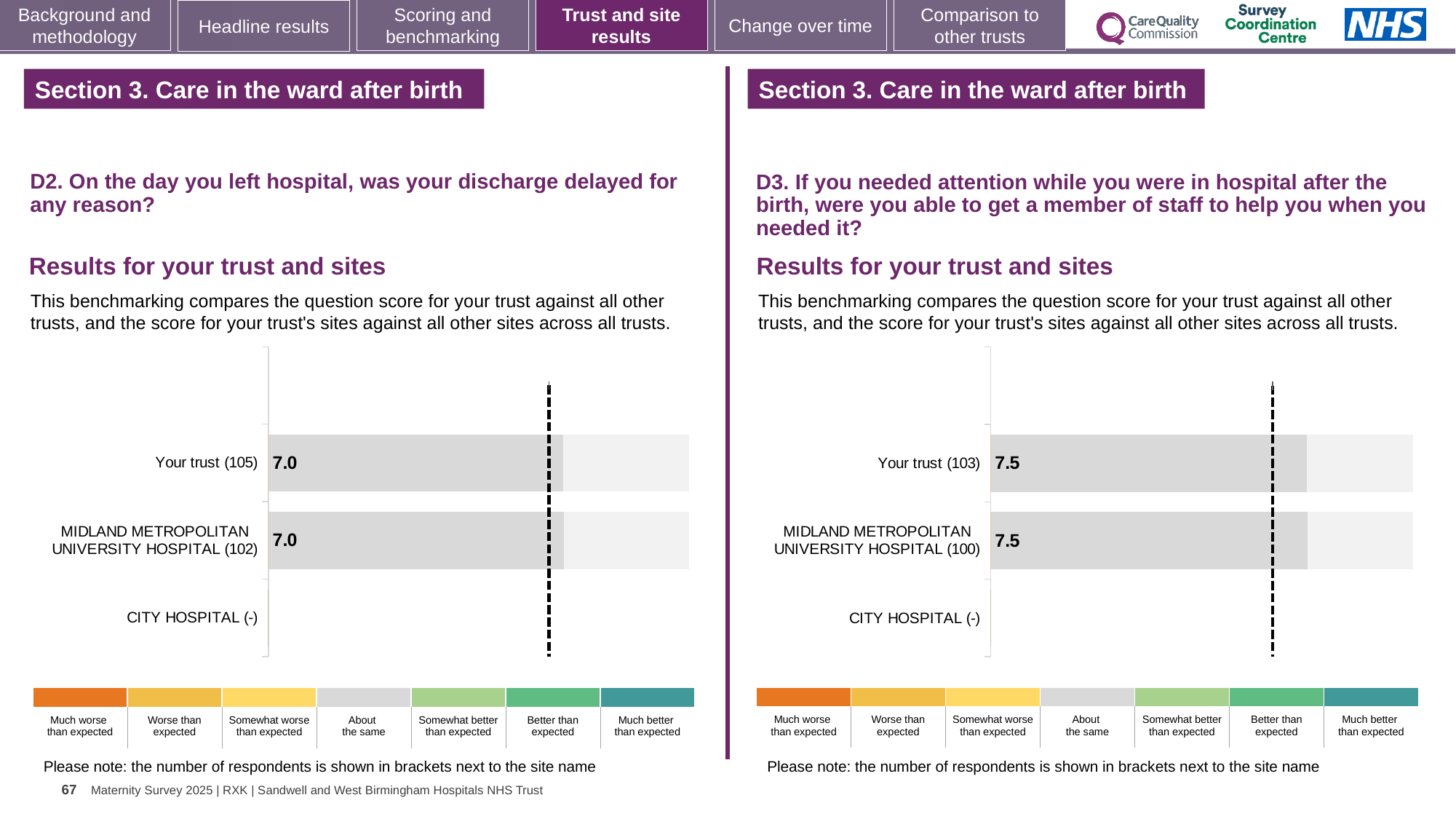
In the D2 chart on the left, what is the score for Your trust (105)? 7.0 In the D2 chart on the left, what is the difference between the score for Your trust and the score for MIDLAND METROPOLITAN UNIVERSITY HOSPITAL? 0.0 What kind of chart is the D2 chart on the left? Bar chart How many respondents are shown in brackets for Your trust in the D3 chart on the right? 103 In the D2 chart on the left, what is the score for MIDLAND METROPOLITAN UNIVERSITY HOSPITAL (102)? 7.0 In the D3 chart on the right, what is the score for MIDLAND METROPOLITAN UNIVERSITY HOSPITAL (100)? 7.5 How many categories are listed on the y axis of the D2 chart on the left? 3 In the D3 chart on the right, what is the score for Your trust (103)? 7.5 In the D2 chart on the left, which category has no bar plotted? CITY HOSPITAL (-) In the D3 chart on the right, what is the difference between the score for Your trust and the score for MIDLAND METROPOLITAN UNIVERSITY HOSPITAL? 0.0 How many categories are listed on the y axis of the D3 chart on the right? 3